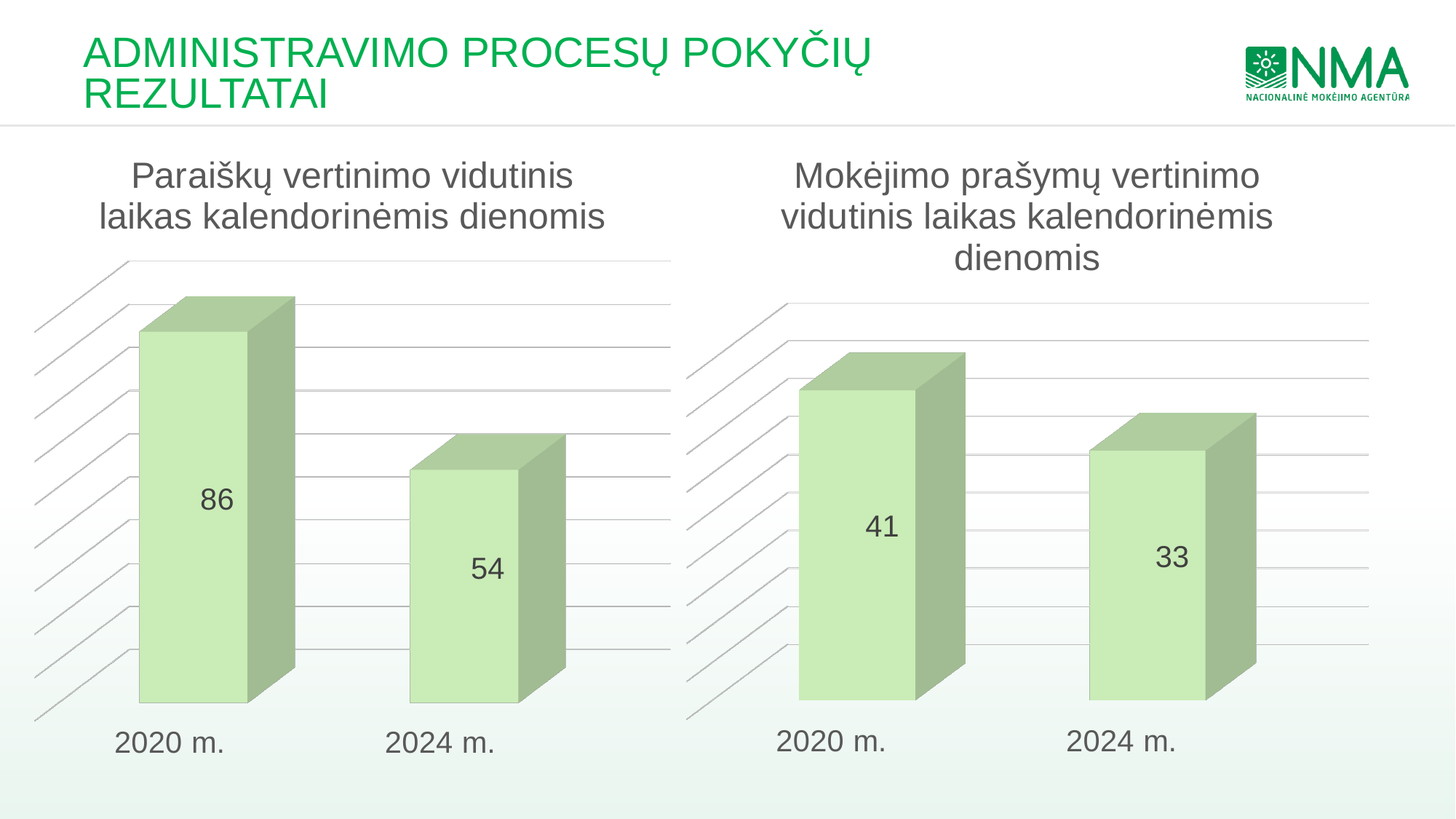
How many bars are shown in the left chart? 2 In the right chart, which year has the lowest value? 2024 m. In the left chart, which year has the highest value? 2020 m. In the right chart (Mokėjimo prašymų vertinimo vidutinis laikas kalendorinėmis dienomis), what is the value for 2024 m.? 33 In the left chart (Paraiškų vertinimo vidutinis laikas kalendorinėmis dienomis), what is the value for 2024 m.? 54 In the right chart (Mokėjimo prašymų vertinimo vidutinis laikas kalendorinėmis dienomis), what is the value for 2020 m.? 41 In the left chart, do the values rise or fall from 2020 m. to 2024 m.? Fall In the right chart, which is larger: the value for 2020 m. or 2024 m.? 2020 m. In the left chart (Paraiškų vertinimo vidutinis laikas kalendorinėmis dienomis), what is the value for 2020 m.? 86 In the left chart, what is the difference between the values for 2020 m. and 2024 m.? 32 In the right chart, what is the difference between the values for 2020 m. and 2024 m.? 8 What kind of chart is the right chart? Bar chart